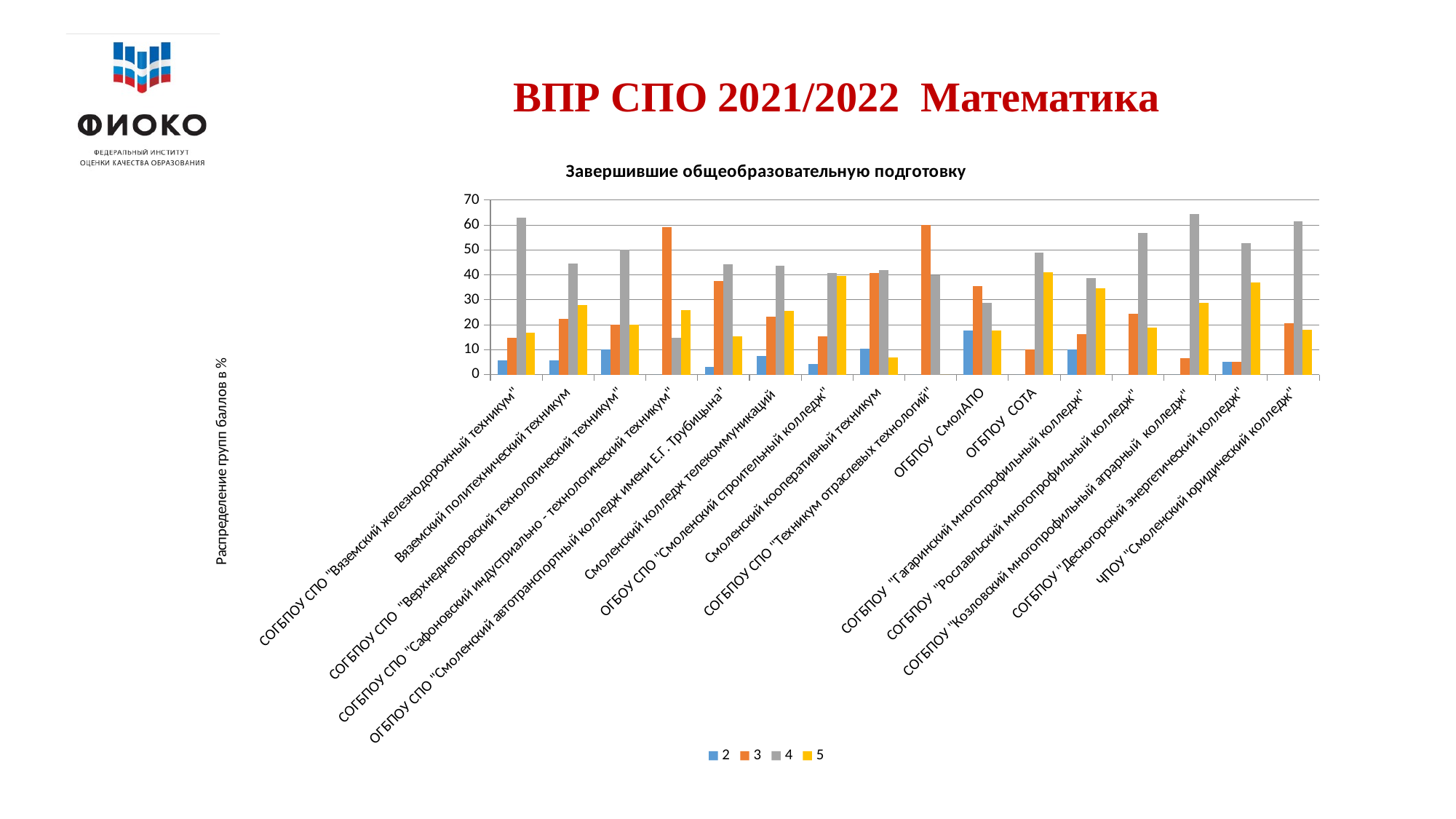
How many institutions (categories) are shown on the x axis? 16 For СОГБПОУ СПО "Вяземский железнодорожный техникум", which is larger: the value of series 3 or series 4? series 4 Is the value of series 4 for СОГБПОУ "Десногорский энергетический колледж" greater or less than 60? less What is the label of the vertical axis? Распределение групп баллов в % Is the value of series 2 for ОГБПОУ СмолАПО greater or less than 10? greater How many series does the legend list? 4 What is the title of the chart? Завершившие общеобразовательную подготовку Is the value of series 5 for ЧПОУ "Смоленский юридический колледж" greater or less than 20? less What kind of chart is shown on the slide? bar chart Which institution has the highest value for series 2? ОГБПОУ СмолАПО